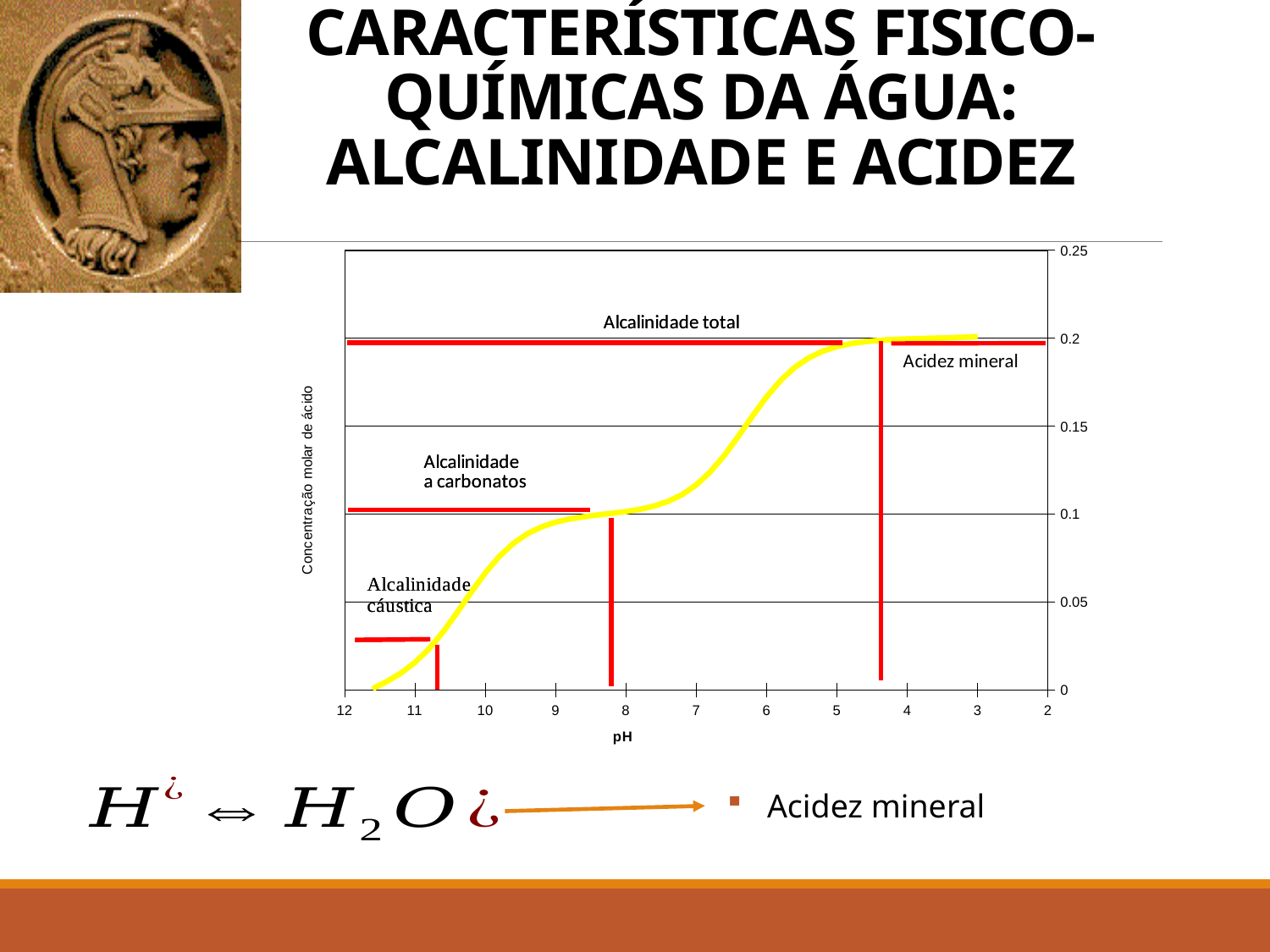
Does the plotted curve rise or fall from left to right along the pH axis? rise Is the value of the curve at pH 9 greater or less than 0.05? greater What label is written above the long red horizontal line at the 0.2 level on the chart? Alcalinidade total Is the value of the curve at pH 10 greater or less than 0.1? less Is the value of the curve at pH 11 greater or less than 0.05? less How many tick labels are shown on the pH axis? 11 What is the label of the vertical axis of the chart? Concentração molar de ácido What kind of chart is shown on the slide? line chart